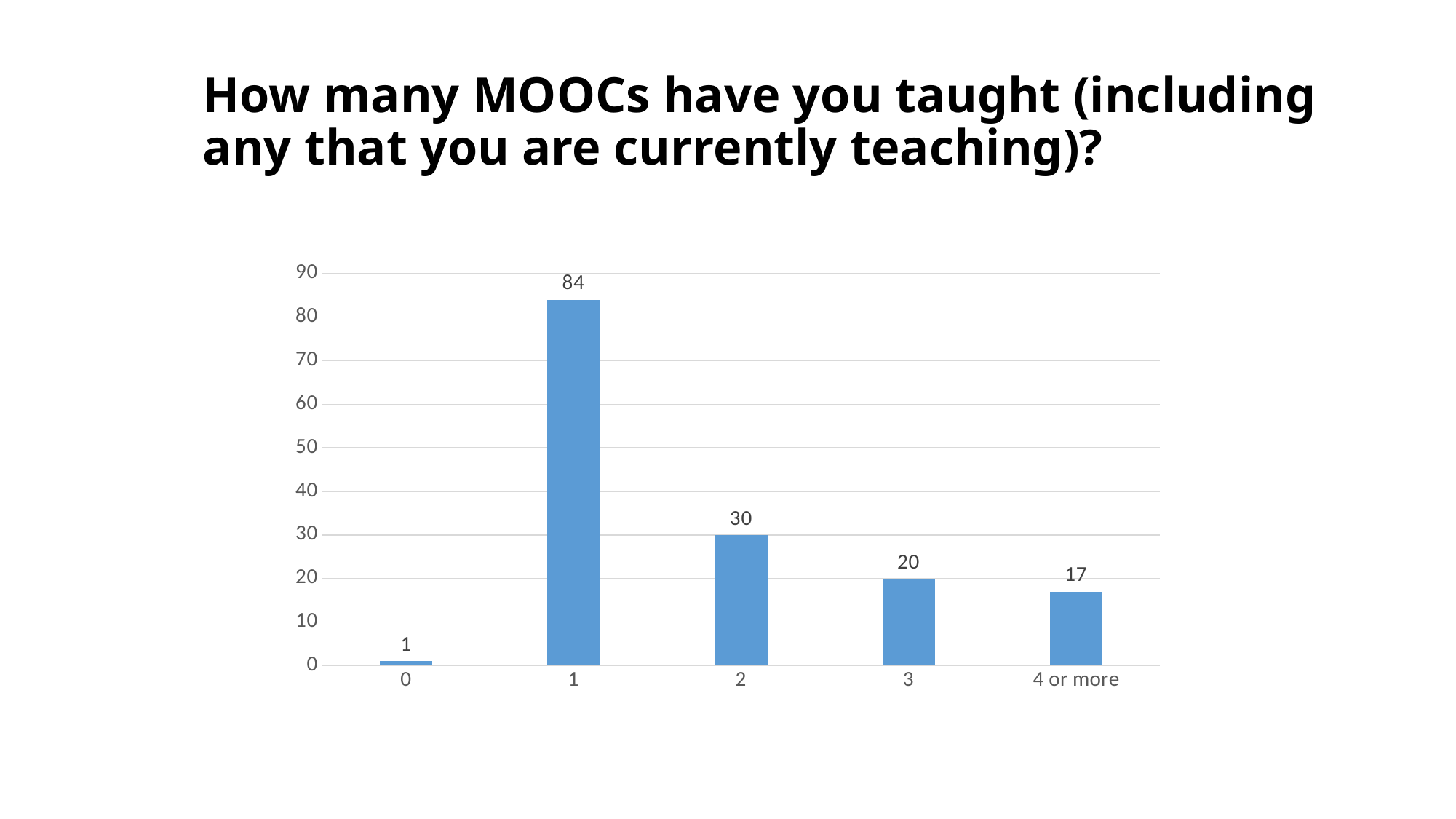
Is the value for "2" greater or less than 40? less How many categories are shown on the x axis? 5 What is the difference between the values for "1" and "2"? 54 Which is larger, the value for "2" or the value for "3"? 2 What is the value for the category "4 or more"? 17 What is the value for the category "0"? 1 Which category has the highest value? 1 What is the value for the category "1"? 84 What kind of chart is shown on the slide? bar chart Which category has the lowest value? 0 What is the difference between the values for "3" and "4 or more"? 3 What is the title of the chart? How many MOOCs have you taught (including any that you are currently teaching)?